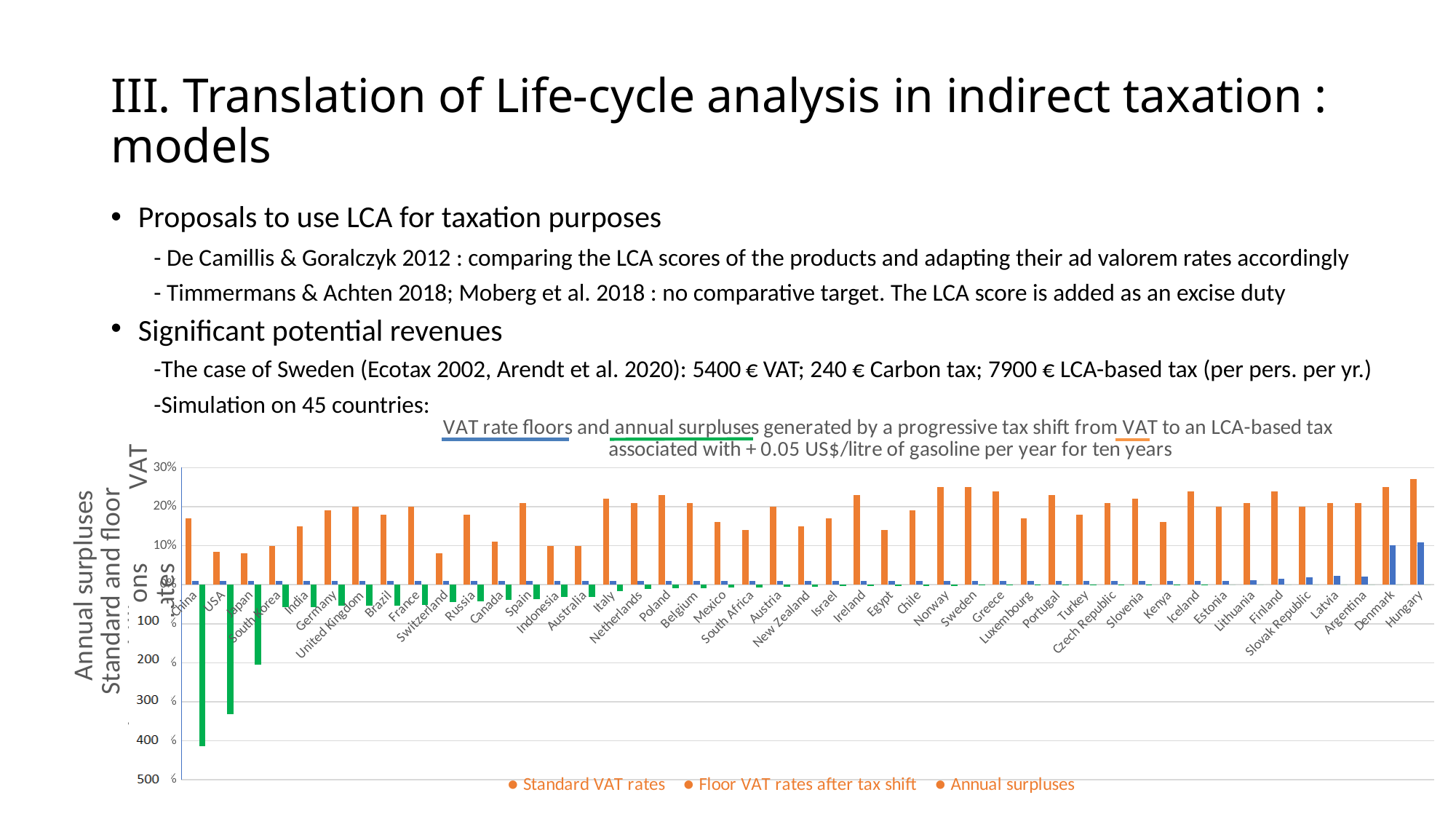
Is the Standard VAT rate for China greater or less than 20%? less What colour are the Standard VAT rates bars in the chart? orange Which has the larger Floor VAT rate after tax shift, Denmark or China? Denmark Is the magnitude of the Annual surpluses bar for Japan greater or less than 300? less Which has the larger Standard VAT rate, Germany or USA? Germany How many countries are plotted along the x axis of the chart? 45 What kind of chart is shown on the slide? bar chart Is the Standard VAT rate for USA greater or less than 10%? less Which country has the largest Annual surpluses bar in the chart? China How many series does the chart legend list? 3 Which country has the highest Standard VAT rate in the chart? Hungary